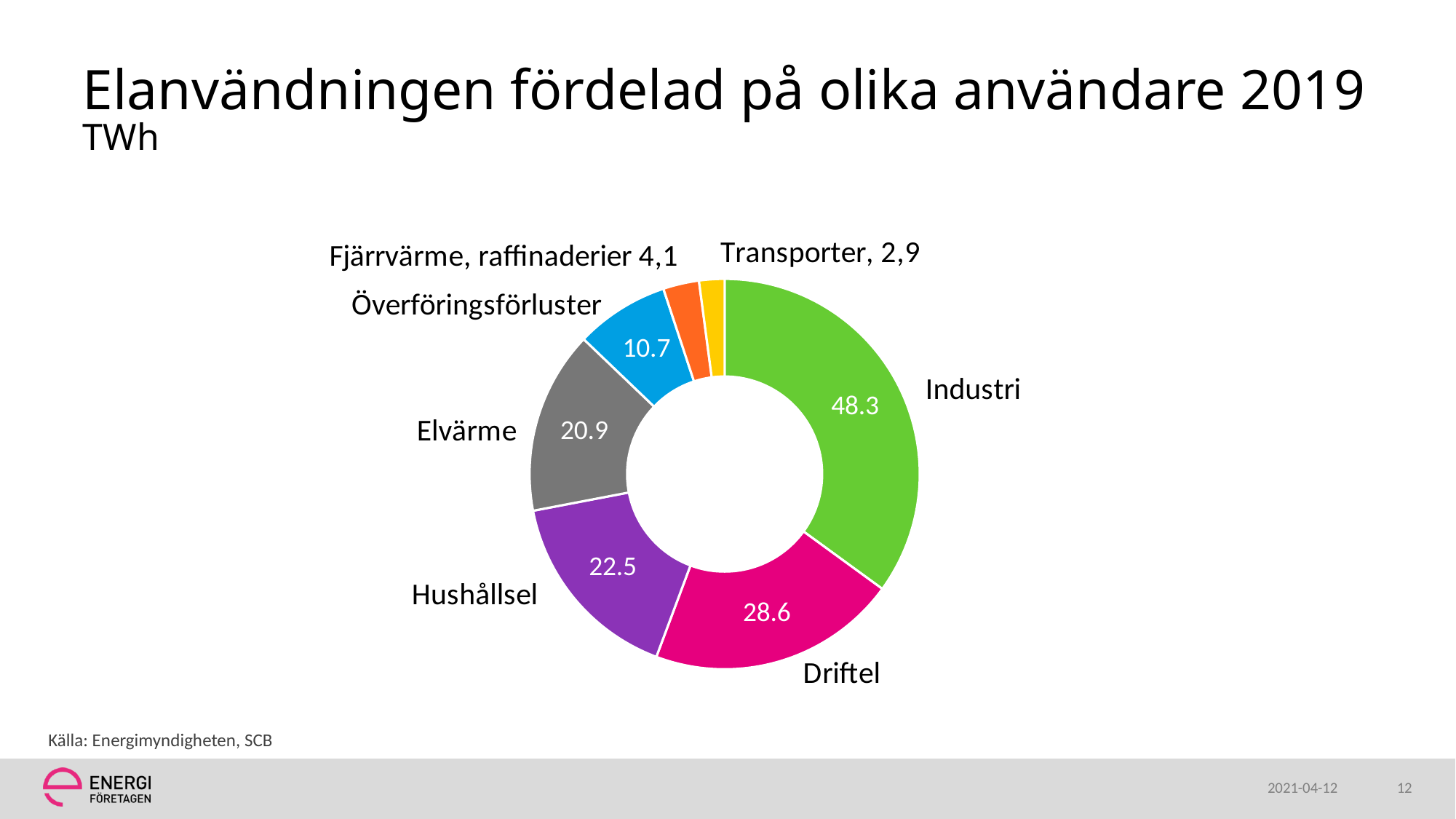
How many categories does the chart show? 7 What is the difference between the values for Industri and Driftel? 19.7 Which category has the highest value? Industri What is the value for Transporter? 2,9 What is the value for Överföringsförluster? 10.7 What is the value for Driftel? 28.6 Which category has the lowest value? Transporter What is the value for Elvärme? 20.9 What kind of chart is shown on the slide? doughnut chart What is the value for Industri? 48.3 Which is larger, Hushållsel or Elvärme? Hushållsel What is the value for Hushållsel? 22.5